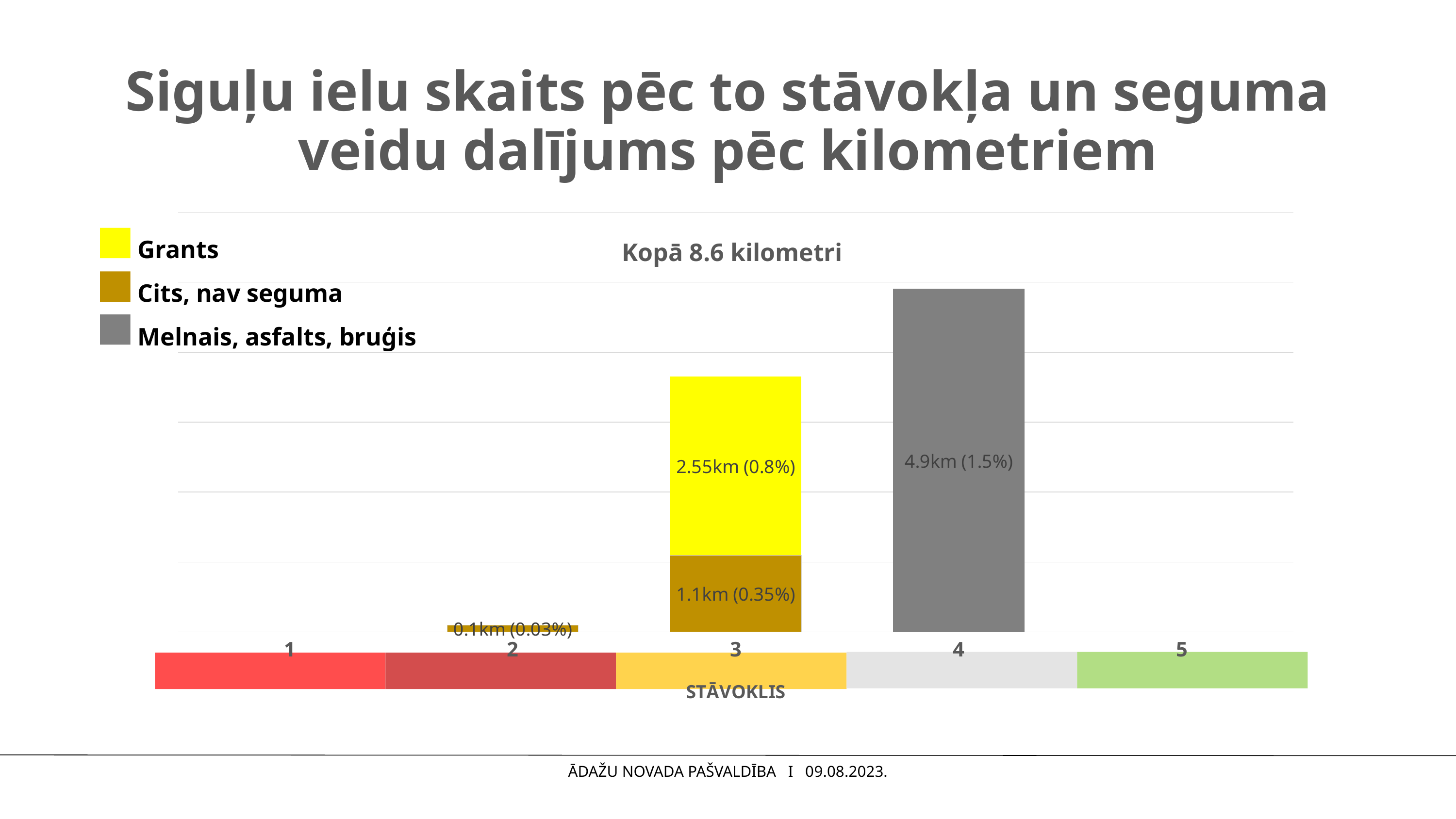
What is the title shown above the chart? Kopā 8.6 kilometri What is the value of the Cits, nav seguma series for category 2? 0.1km (0.03%) What is the value of the Cits, nav seguma series for category 3? 1.1km (0.35%) How many categories are shown on the x axis? 5 What kind of chart is shown on the slide? Stacked bar chart How many series does the legend list? 3 Which is larger: the Grants value for category 3 or the Cits, nav seguma value for category 3? Grants value for category 3 What is the difference in kilometres between the Melnais, asfalts, bruģis value for category 4 and the Grants value for category 3? 2.35km What is the value of the Grants series for category 3? 2.55km (0.8%) What is the total length of the stacked bar for category 3? 3.65km Which category has the tallest bar? 4 What is the value of the Melnais, asfalts, bruģis series for category 4? 4.9km (1.5%)